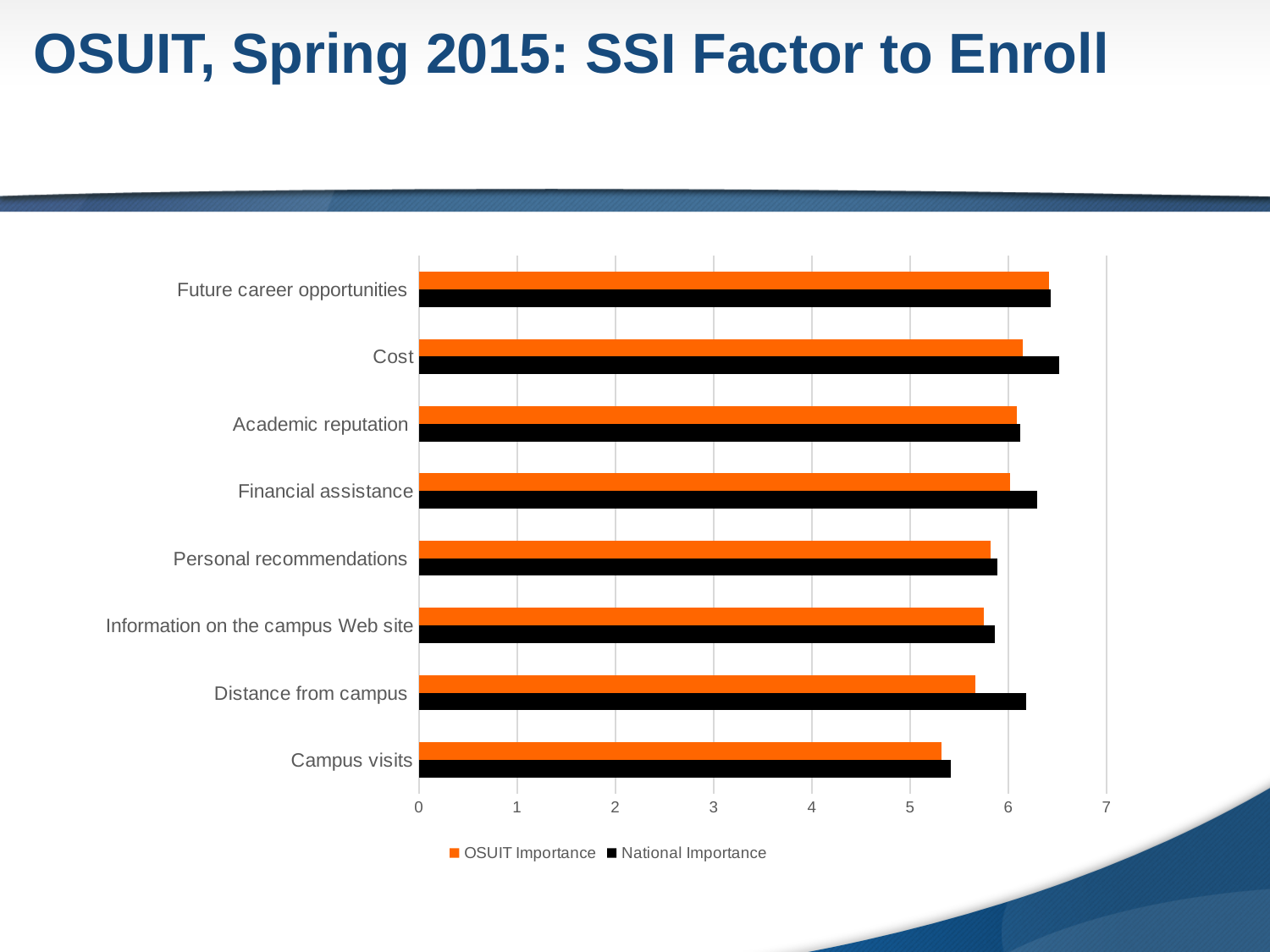
Which colour represents the OSUIT Importance series? Orange Which factor has the highest OSUIT Importance value? Future career opportunities For Distance from campus, which is larger: OSUIT Importance or National Importance? National Importance For Cost, which is larger: OSUIT Importance or National Importance? National Importance How many factors (categories) are listed on the chart? 8 Is the OSUIT Importance value for Campus visits greater or less than 5? greater Which factor has the lowest National Importance value? Campus visits Is the OSUIT Importance value for Distance from campus greater or less than 6? less How many series does the legend list? 2 Is the National Importance value for Cost greater or less than 6? greater What kind of chart is shown on the slide? Bar chart Which factor has the lowest OSUIT Importance value? Campus visits